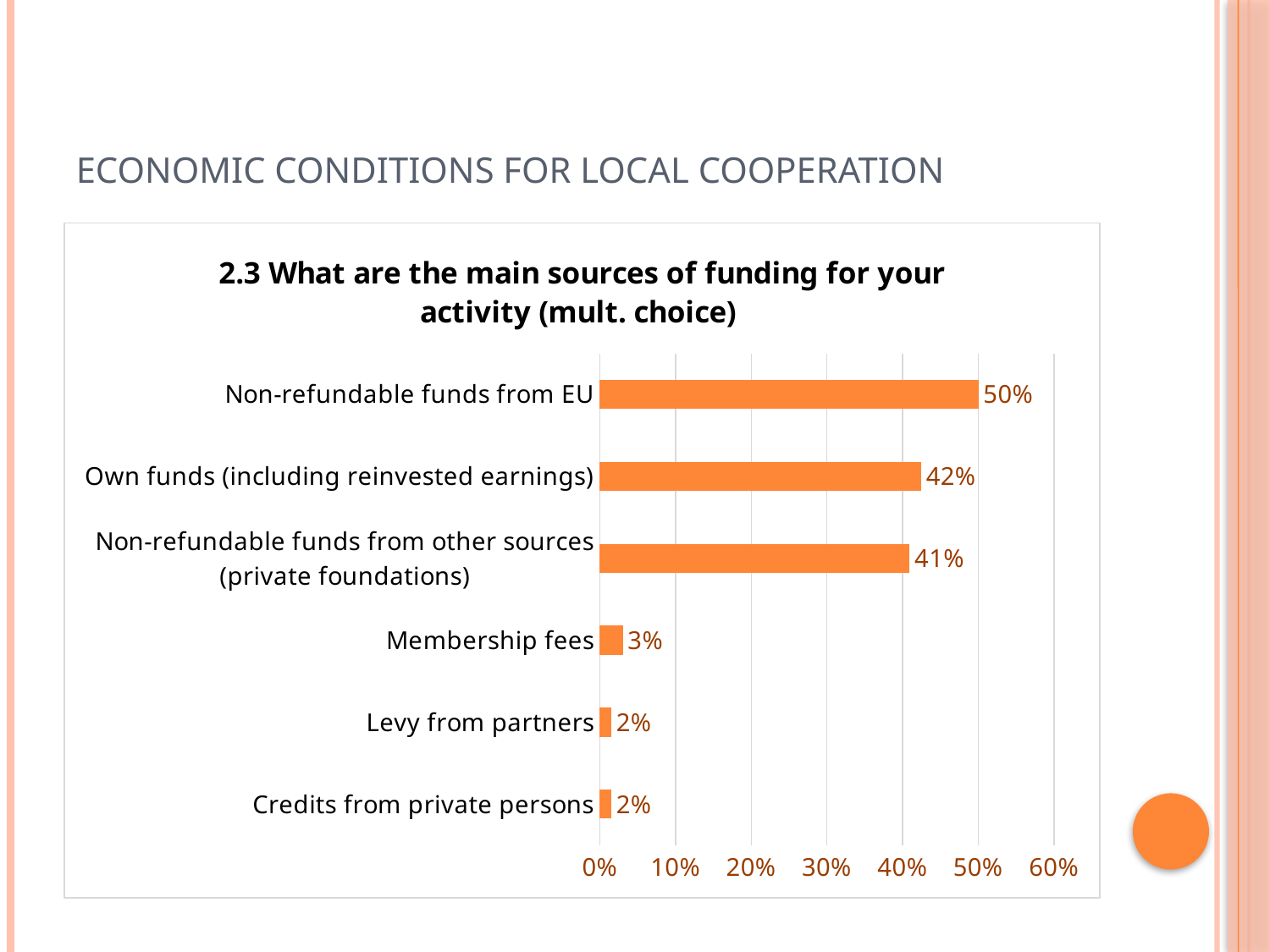
What is the value for Own funds (including reinvested earnings)? 42% Which is larger, Own funds (including reinvested earnings) or Non-refundable funds from other sources (private foundations)? Own funds (including reinvested earnings) What is the value for Non-refundable funds from EU? 50% How many funding sources are shown in the chart? 6 Is the value for Non-refundable funds from other sources (private foundations) greater or less than 30%? greater What kind of chart is shown on the slide? Bar chart Which funding source has the highest value? Non-refundable funds from EU What is the difference between Membership fees and Levy from partners? 1% What is the difference between Non-refundable funds from EU and Own funds (including reinvested earnings)? 8% What is the title of the chart? 2.3 What are the main sources of funding for your activity (mult. choice) What is the value for Membership fees? 3% What is the highest value shown on the x axis? 60%